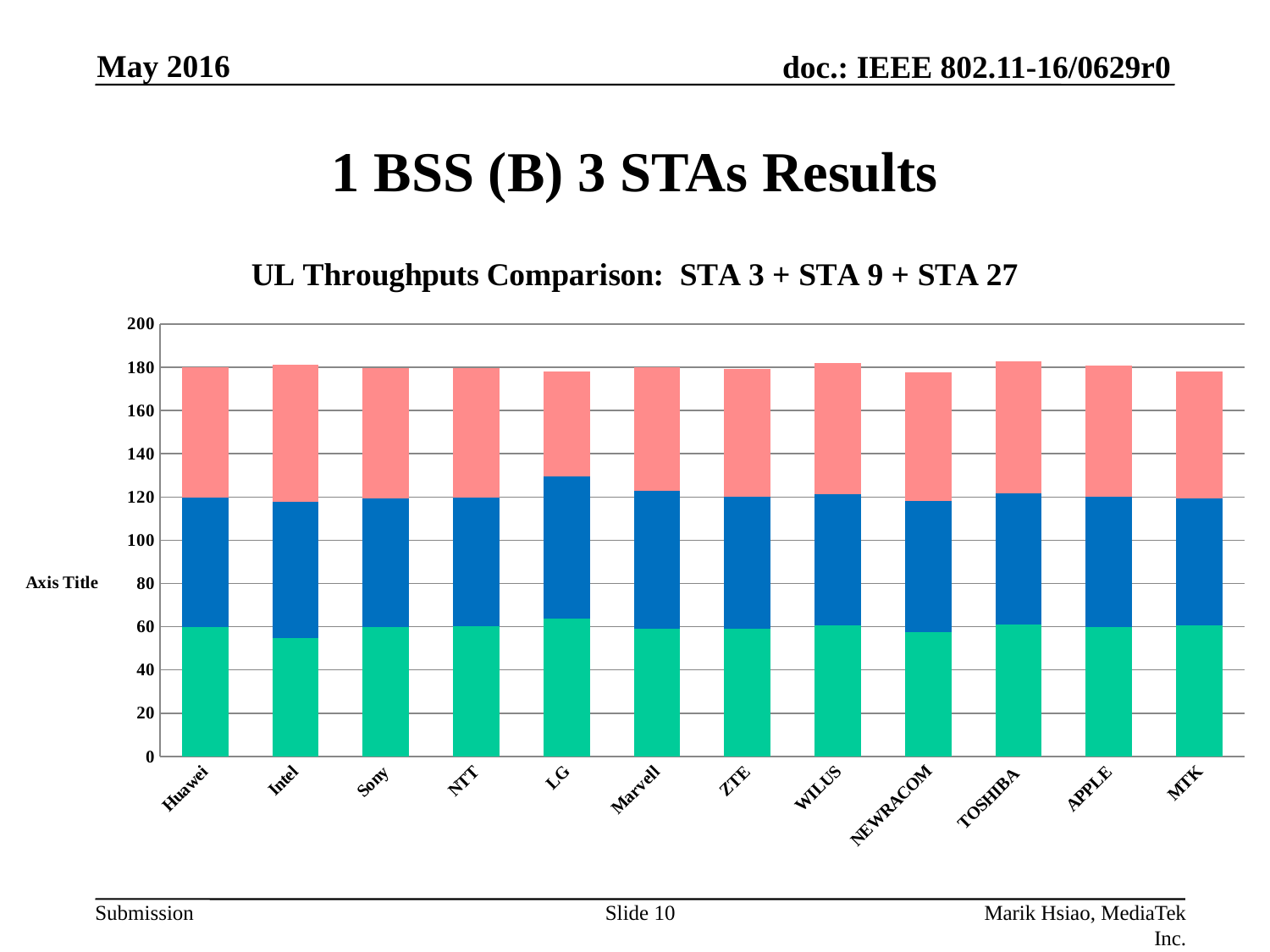
What label is shown on the vertical axis of the chart? Axis Title How many companies (categories) are shown on the x axis of the chart? 12 Is the top of the middle (blue) segment for LG greater or less than 120? greater Which company's middle (blue) segment reaches the highest point on the axis? LG Is the bottom (green) segment for Sony greater or less than 80? less Is the total stacked value for Intel greater or less than 140? greater What kind of chart is shown on the slide? Stacked bar chart Which company has the tallest bottom (green) segment? LG What is the highest value shown on the vertical axis of the chart? 200 What is the title of the chart? UL Throughputs Comparison: STA 3 + STA 9 + STA 27